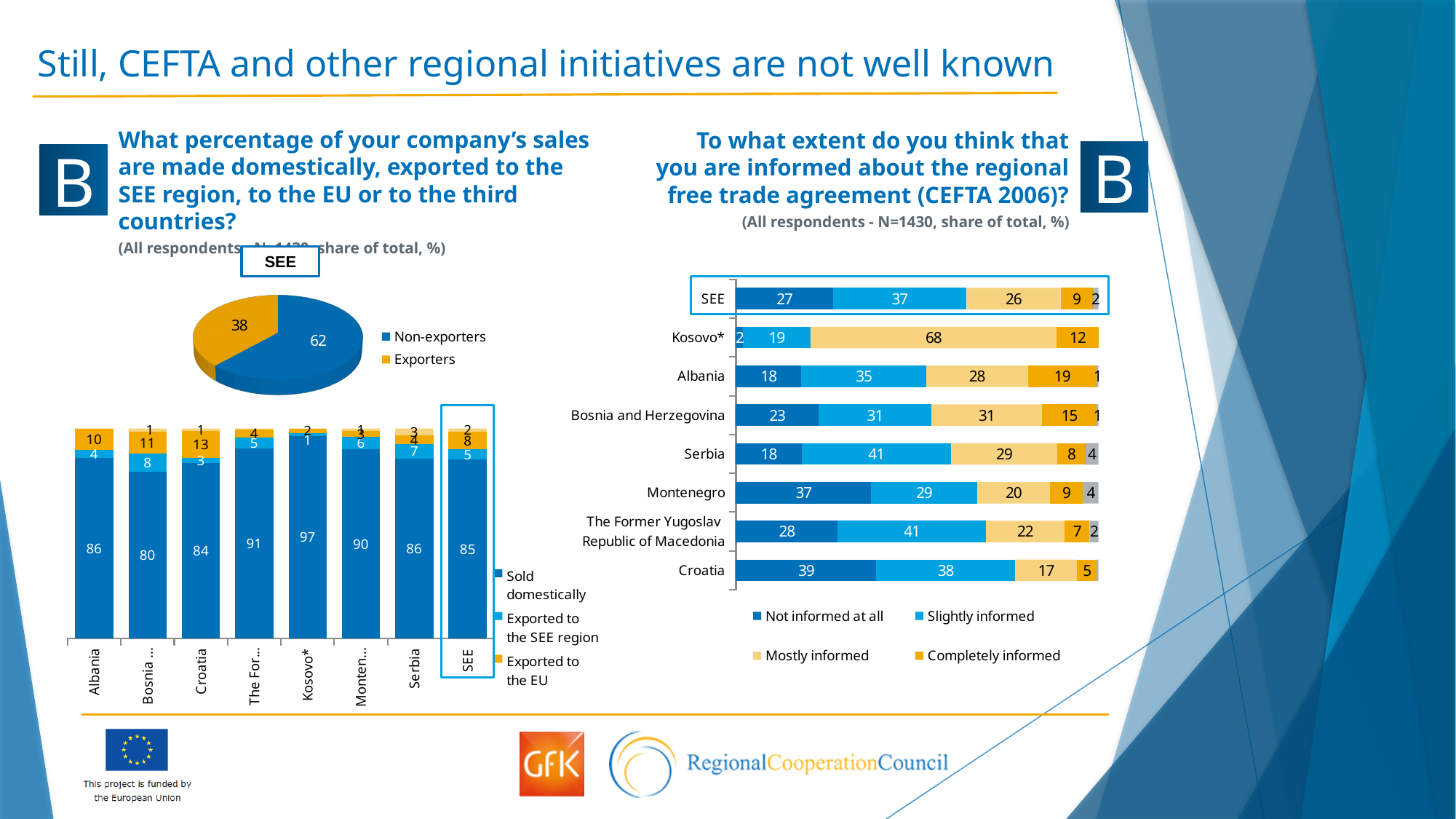
In the chart on the right about being informed about CEFTA 2006, is the Not informed at all value larger for Montenegro or for Serbia? Montenegro In the chart on the right about being informed about CEFTA 2006, what is the Not informed at all value for Croatia? 39 What kind of chart is the SEE chart showing Non-exporters and Exporters? pie chart In the chart on the right about being informed about CEFTA 2006, which country has the highest Mostly informed value? Kosovo* In the pie chart titled SEE, what share of the pie do Exporters take? 38 In the stacked bar chart on the left about company sales, what is the Sold domestically value for Croatia? 84 In the pie chart titled SEE, what value is shown for Non-exporters? 62 In the stacked bar chart on the left about company sales, what is the difference between the Sold domestically values for Kosovo* and Serbia? 11 In the chart on the right about being informed about CEFTA 2006, what is the difference between the Slightly informed values for Serbia and Albania? 6 In the stacked bar chart on the left about company sales, what is the Exported to the EU value for SEE? 8 In the chart on the right about being informed about CEFTA 2006, how many series does the legend list? 4 In the stacked bar chart on the left about company sales, which country has the highest value for Sold domestically? Kosovo*